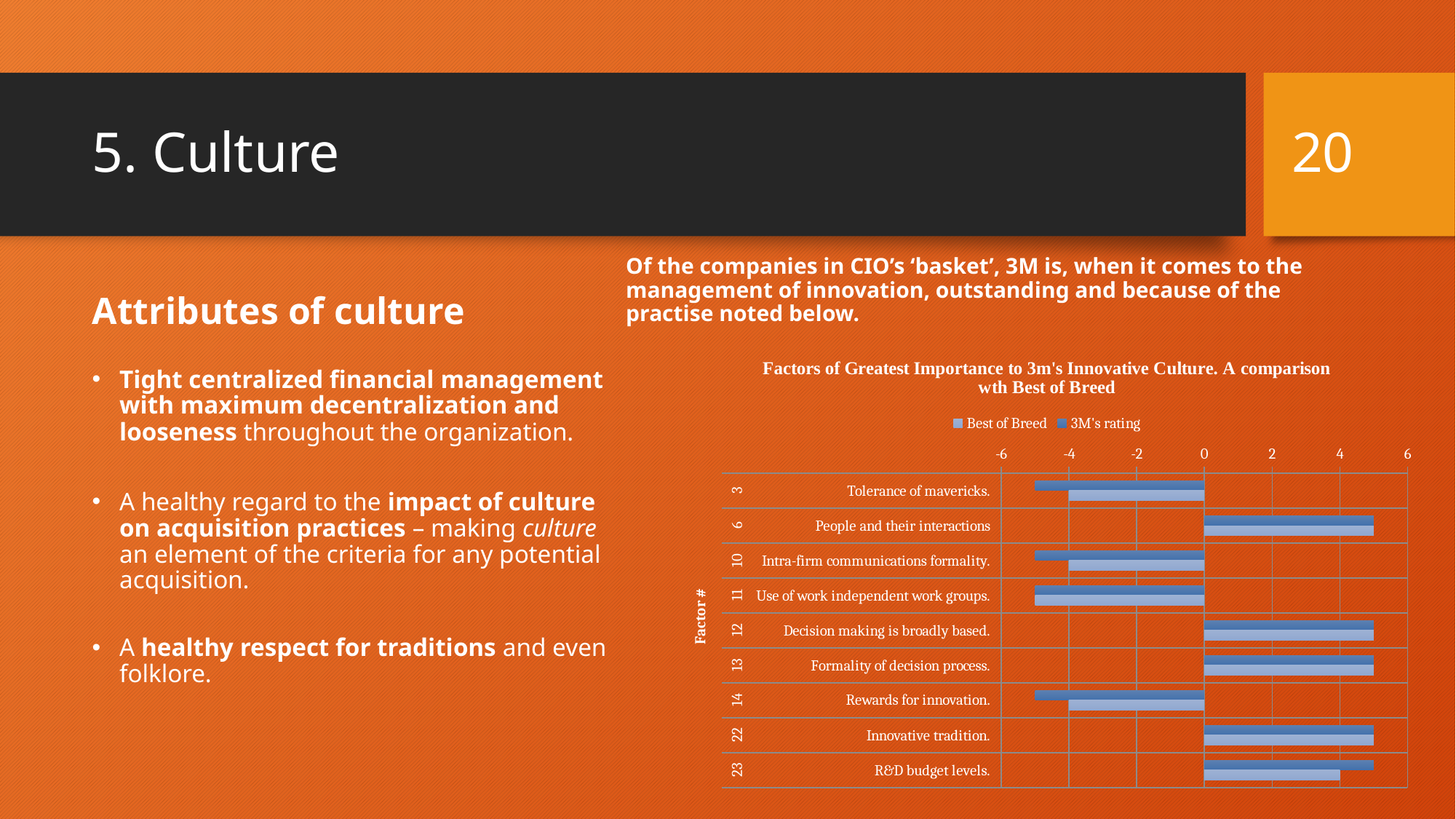
What are the two series named in the chart legend? Best of Breed and 3M's rating Is the Best of Breed value for 'Decision making is broadly based.' greater or less than 2? greater Is the 3M's rating value for 'People and their interactions' greater or less than 2? greater Is the 3M's rating value for 'Rewards for innovation.' greater or less than 0? less Which factor number is shown for 'R&D budget levels.'? 23 What is the title of the chart's vertical axis? Factor # How many factors (categories) are plotted in the chart? 9 What kind of chart is shown on the slide? bar chart How many series does the chart legend list? 2